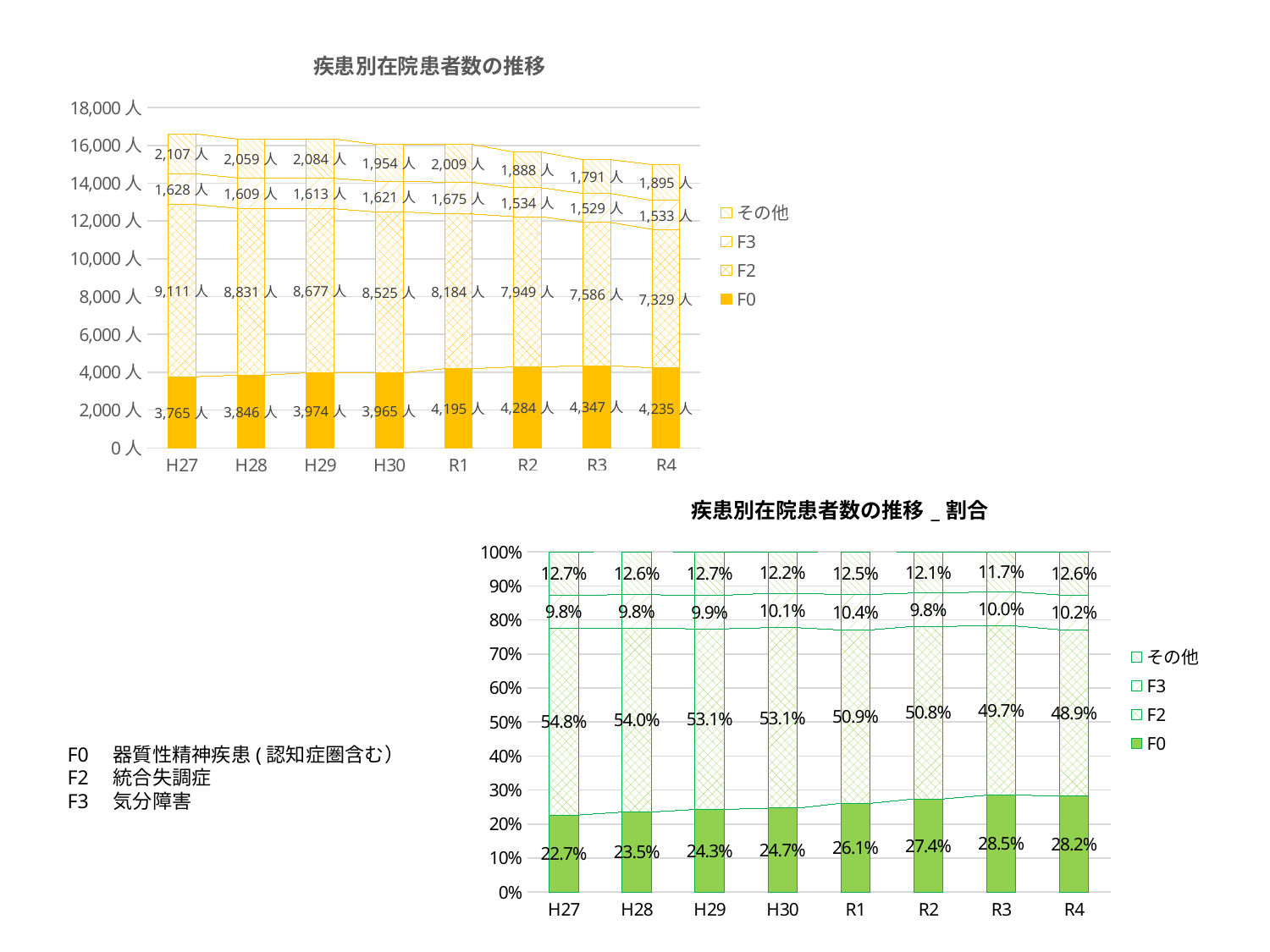
In the bottom chart (疾患別在院患者数の推移＿割合), is the F3 share in R1 larger or the F3 share in H27? R1 In the top chart (疾患別在院患者数の推移), what is the difference between the F2 value in H27 and the F2 value in R4? 1,782 人 In the top chart (疾患別在院患者数の推移), how many series does the legend list? 4 What kind of chart is the bottom chart (疾患別在院患者数の推移＿割合)? stacked bar chart In the bottom chart (疾患別在院患者数の推移＿割合), which year has the highest F2 share? H27 In the top chart (疾患別在院患者数の推移), what is the value for F0 in R4? 4,235 人 In the top chart (疾患別在院患者数の推移), what is the total of the stacked bar for H27? 16,611 人 In the bottom chart (疾患別在院患者数の推移＿割合), what is the share for F0 in R3? 28.5% In the top chart (疾患別在院患者数の推移), which year has the lowest F2 value? R4 In the top chart (疾患別在院患者数の推移), which year has the highest F0 value? R3 In the top chart (疾患別在院患者数の推移), what is the value for F2 in H27? 9,111 人 In the top chart (疾患別在院患者数の推移), does the F2 value rise or fall from H27 to R4? fall